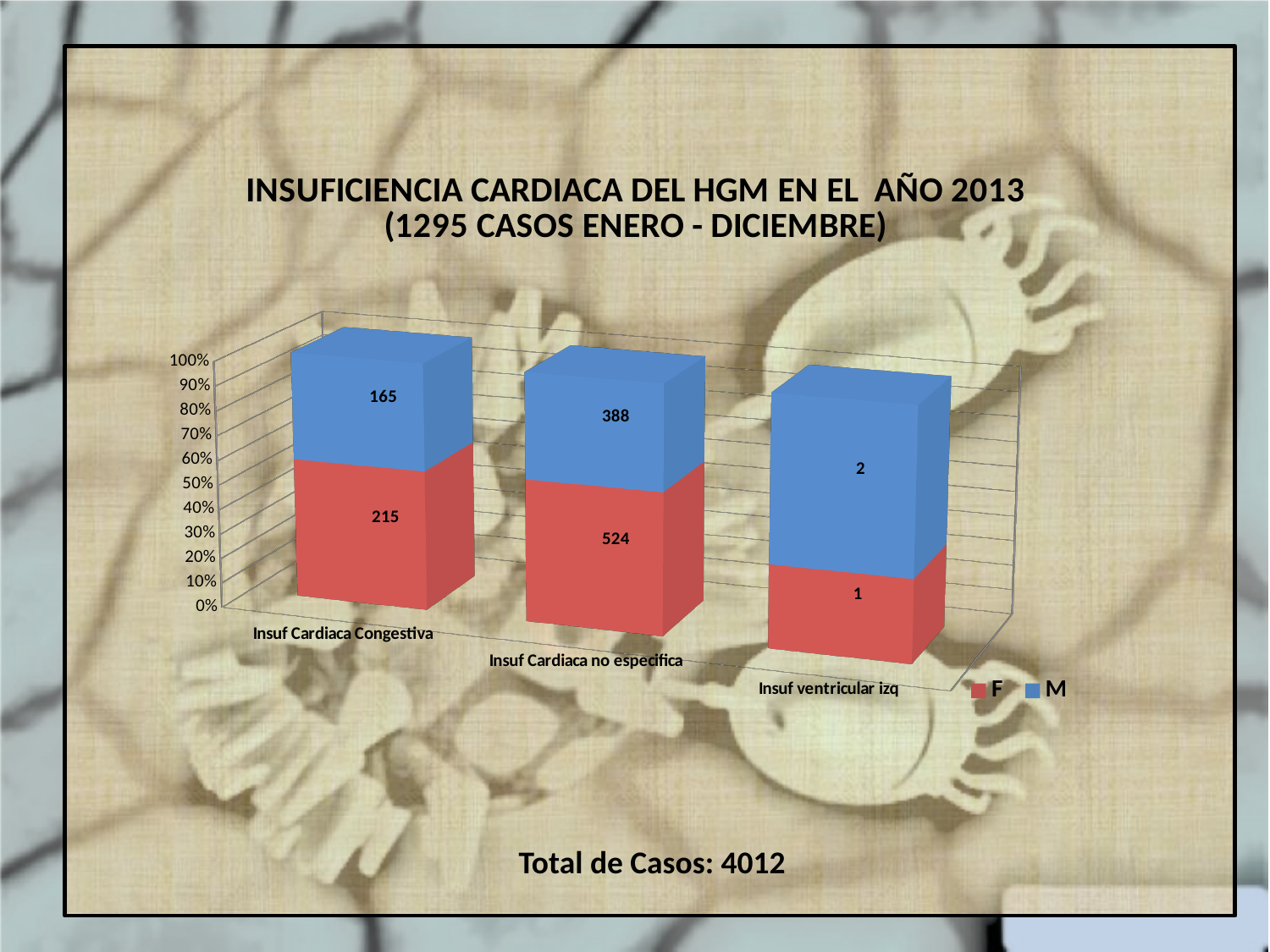
What is the F value for Insuf ventricular izq? 1 How many series does the legend list? 2 What is the F value for Insuf Cardiaca Congestiva? 215 How many categories are shown on the x axis? 3 What is the M value for Insuf Cardiaca no especifica? 388 Which category has the highest F value? Insuf Cardiaca no especifica Which category has the lowest M value? Insuf ventricular izq What kind of chart is shown on the slide? Stacked bar chart What is the M value for Insuf ventricular izq? 2 What is the total of the F and M values for Insuf Cardiaca no especifica? 912 Which is larger for Insuf Cardiaca no especifica, the F value or the M value? F What is the difference between the F and M values for Insuf Cardiaca Congestiva? 50